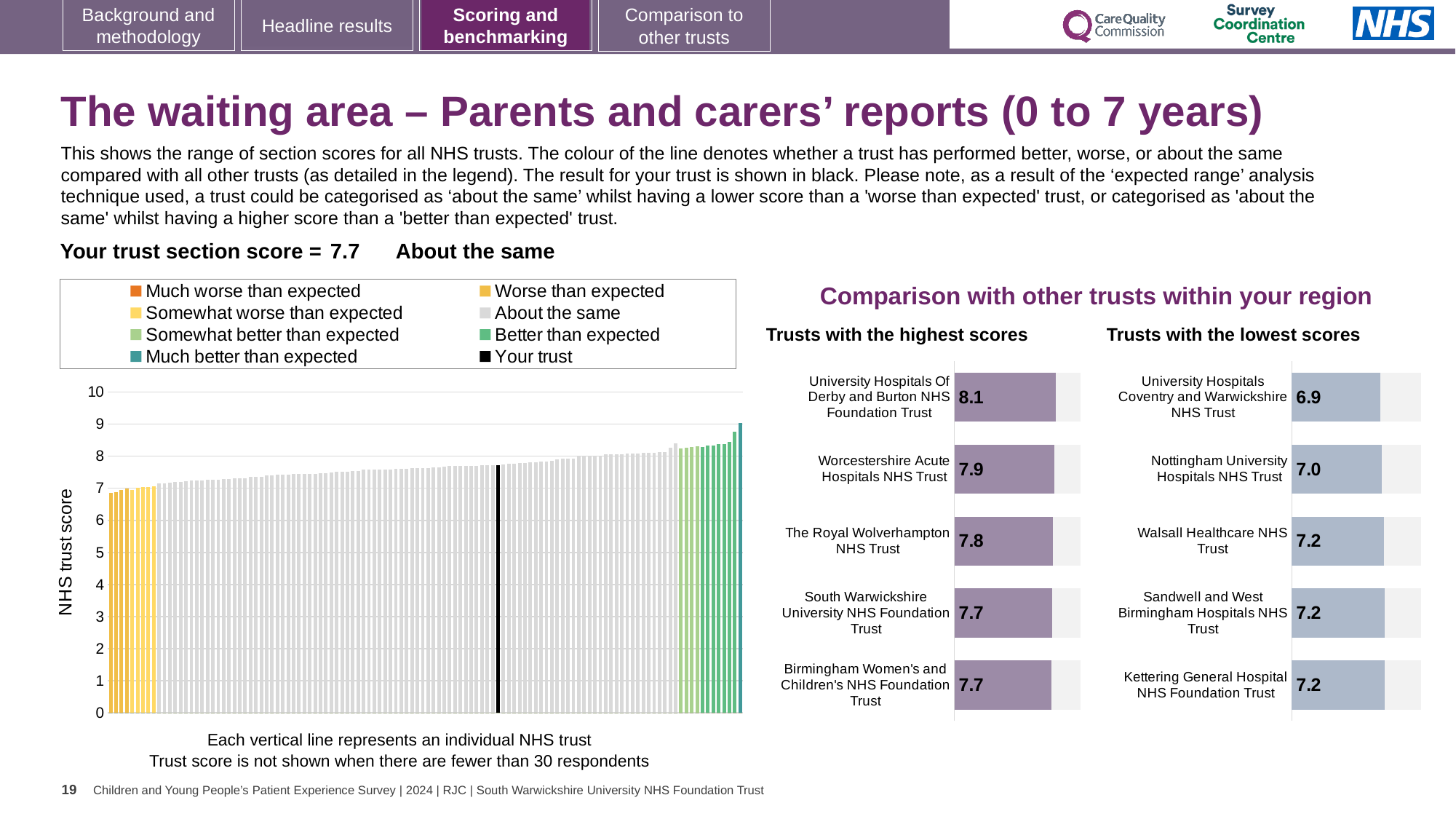
In the 'Trusts with the highest scores' chart, what is the score for University Hospitals Of Derby and Burton NHS Foundation Trust? 8.1 In the 'Trusts with the lowest scores' chart, what is the score for Nottingham University Hospitals NHS Trust? 7.0 In the 'Trusts with the lowest scores' chart, which has the larger score: University Hospitals Coventry and Warwickshire NHS Trust or Kettering General Hospital NHS Foundation Trust? Kettering General Hospital NHS Foundation Trust In the 'Trusts with the highest scores' chart, which trust has the highest score? University Hospitals Of Derby and Burton NHS Foundation Trust In the 'Trusts with the highest scores' chart, what is the score for The Royal Wolverhampton NHS Trust? 7.8 In the 'Trusts with the lowest scores' chart, what is the difference between the scores of Walsall Healthcare NHS Trust and University Hospitals Coventry and Warwickshire NHS Trust? 0.3 In the large chart on the left, do the trust scores rise or fall from left to right? Rise How many entries does the legend of the large chart on the left list? 8 What kind of chart is the large chart on the left showing NHS trust scores? Bar chart In the 'Trusts with the highest scores' chart, what is the difference between the scores of University Hospitals Of Derby and Burton NHS Foundation Trust and Worcestershire Acute Hospitals NHS Trust? 0.2 In the 'Trusts with the lowest scores' chart, which trust has the lowest score? University Hospitals Coventry and Warwickshire NHS Trust How many trusts are listed in the 'Trusts with the highest scores' chart? 5